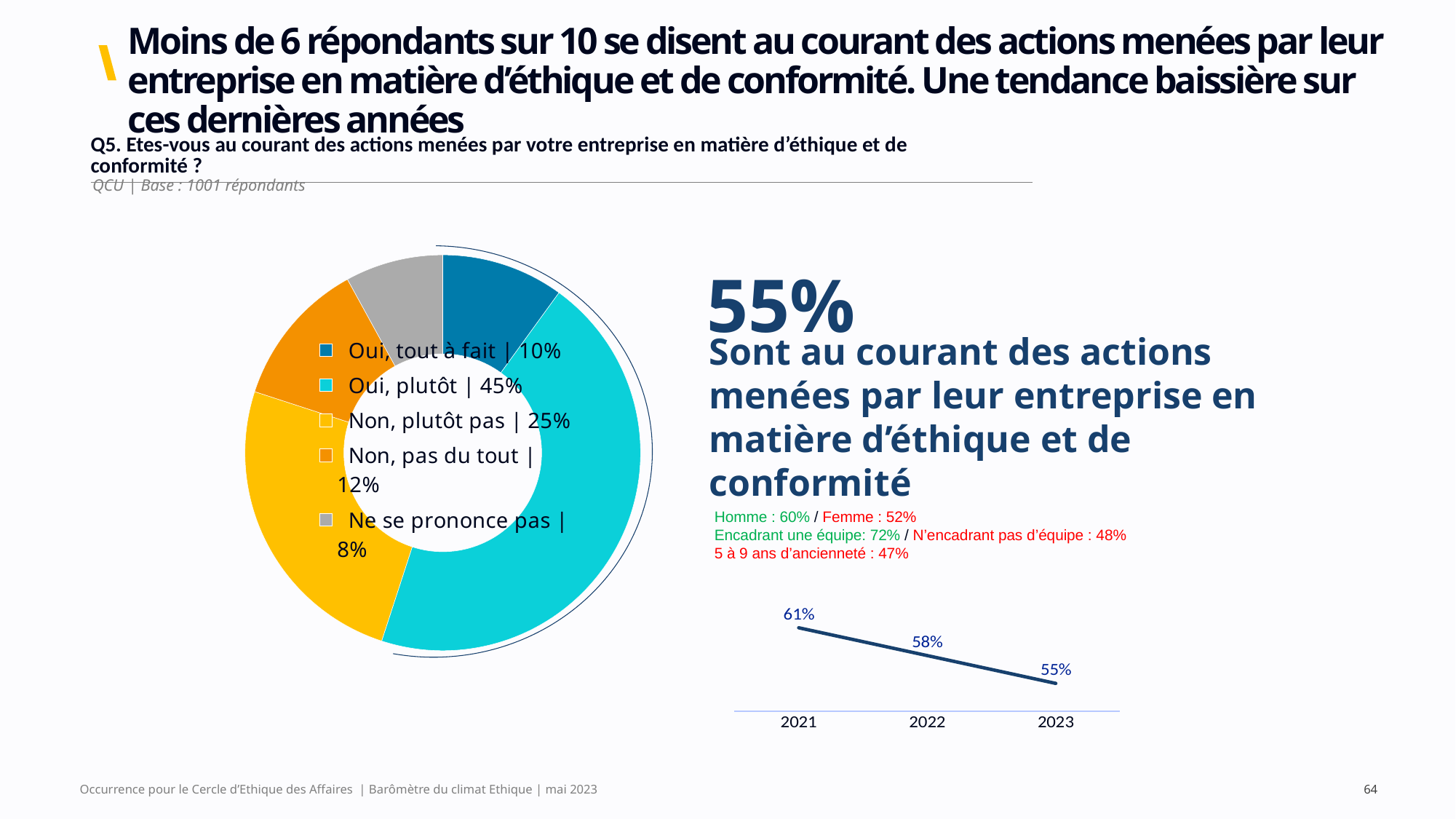
On the doughnut chart on the left, which is larger: "Non, plutôt pas" or "Non, pas du tout"? Non, plutôt pas How many data points are plotted on the line chart at the bottom right? 3 On the line chart at the bottom right, do the values rise or fall from 2021 to 2023? Fall On the line chart at the bottom right, what is the difference between the 2021 and 2023 values? 6% On the doughnut chart on the left, what is the difference between "Non, plutôt pas" and "Oui, tout à fait"? 15% On the doughnut chart on the left, what is the value for "Non, pas du tout"? 12% On the doughnut chart on the left, what is the value for "Oui, plutôt"? 45% What kind of chart is shown on the left of the slide? Doughnut (pie) chart On the line chart at the bottom right, what is the value for 2022? 58% On the doughnut chart on the left, which category has the largest share? Oui, plutôt How many categories does the legend of the doughnut chart on the left list? 5 On the doughnut chart on the left, which category has the smallest share? Ne se prononce pas